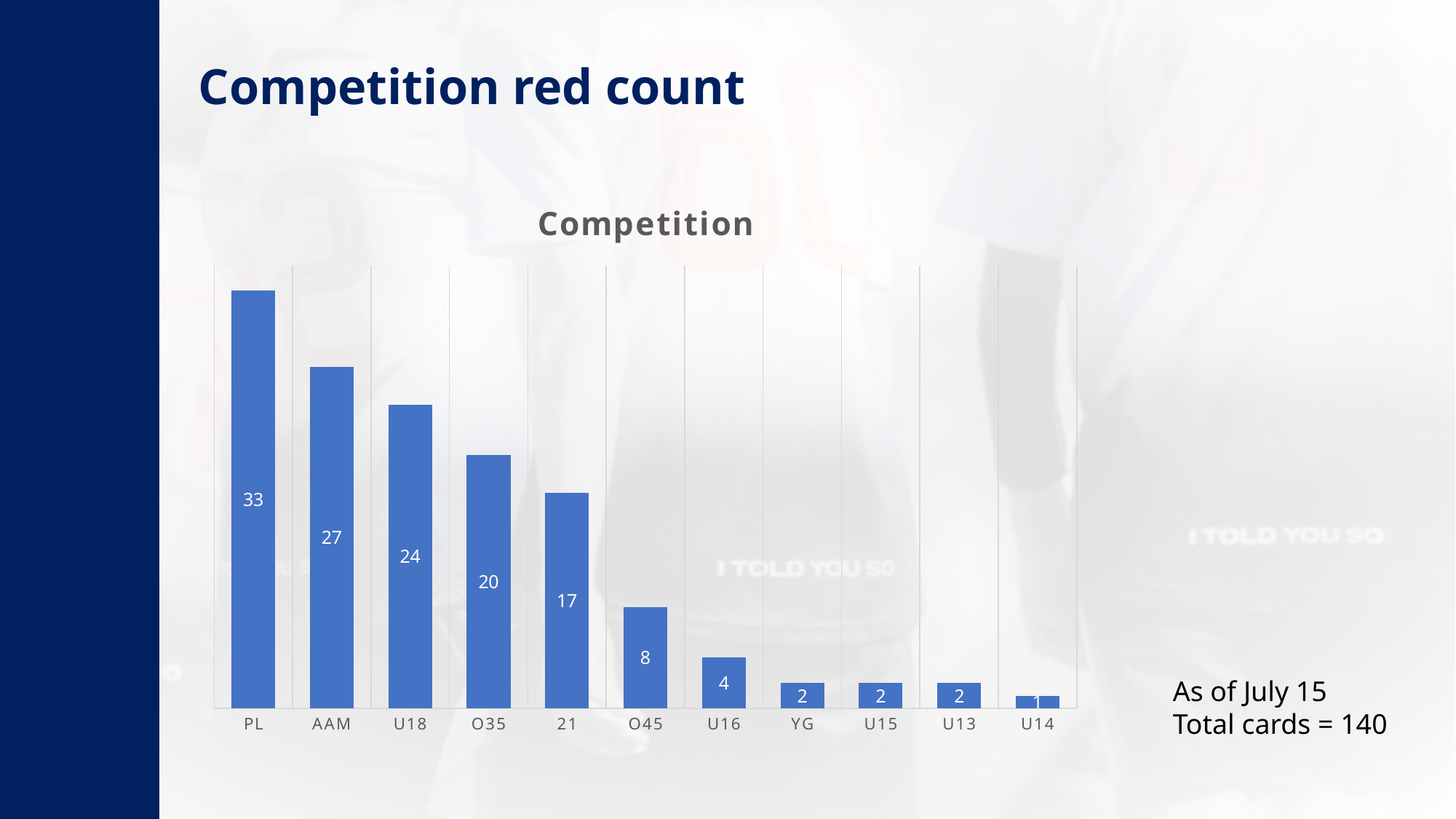
What is the difference between the values for AAM and U18 in the Competition chart? 3 Which is larger in the Competition chart, the value for 21 or the value for O45? 21 What is the value for U16 in the Competition chart? 4 What is the value for O35 in the Competition chart? 20 Which category has the highest value in the Competition chart? PL How many categories are shown in the Competition chart? 11 What is the value for PL in the Competition chart? 33 Do the values rise or fall from left to right across the categories in the Competition chart? fall What is the title of the chart on the slide? Competition What is the difference between the values for PL and O45 in the Competition chart? 25 What kind of chart is shown on the slide? bar chart Which category has the lowest value in the Competition chart? U14